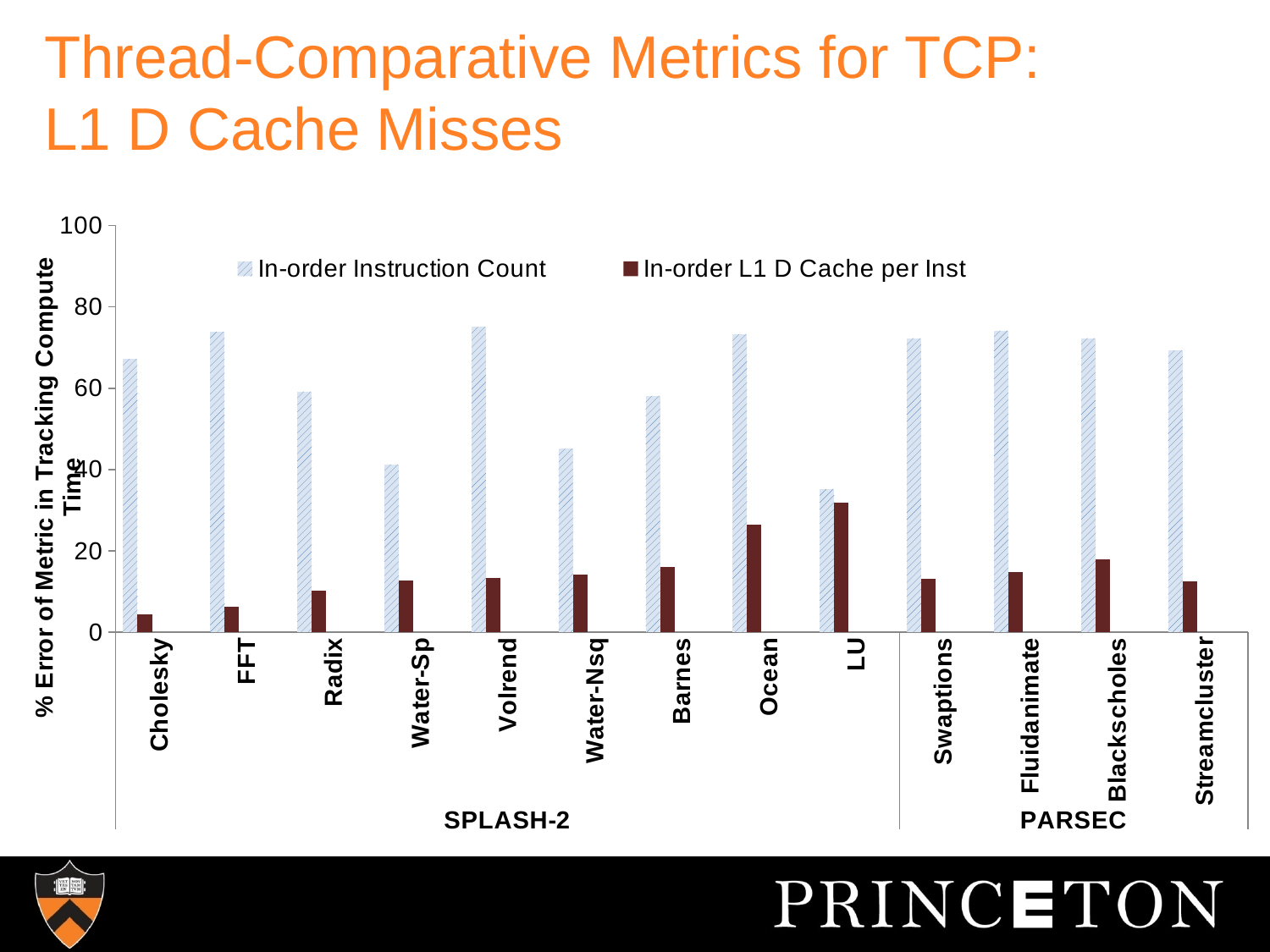
How many benchmark categories are plotted along the x axis? 13 What are the two benchmark suite groups labelled below the x axis? SPLASH-2 and PARSEC Which category has the highest value for In-order L1 D Cache per Inst? LU For Ocean, which series has the larger value: In-order Instruction Count or In-order L1 D Cache per Inst? In-order Instruction Count Which category has the lowest value for In-order L1 D Cache per Inst? Cholesky Is the In-order Instruction Count value for Cholesky greater or less than 60? greater Is the In-order L1 D Cache per Inst value for Ocean greater or less than 20? greater What kind of chart is shown on the slide? bar chart Is the In-order Instruction Count value for LU greater or less than 40? less Which category has the lowest value for In-order Instruction Count? LU Which has the larger In-order Instruction Count value, Volrend or Water-Sp? Volrend How many series does the legend list? 2